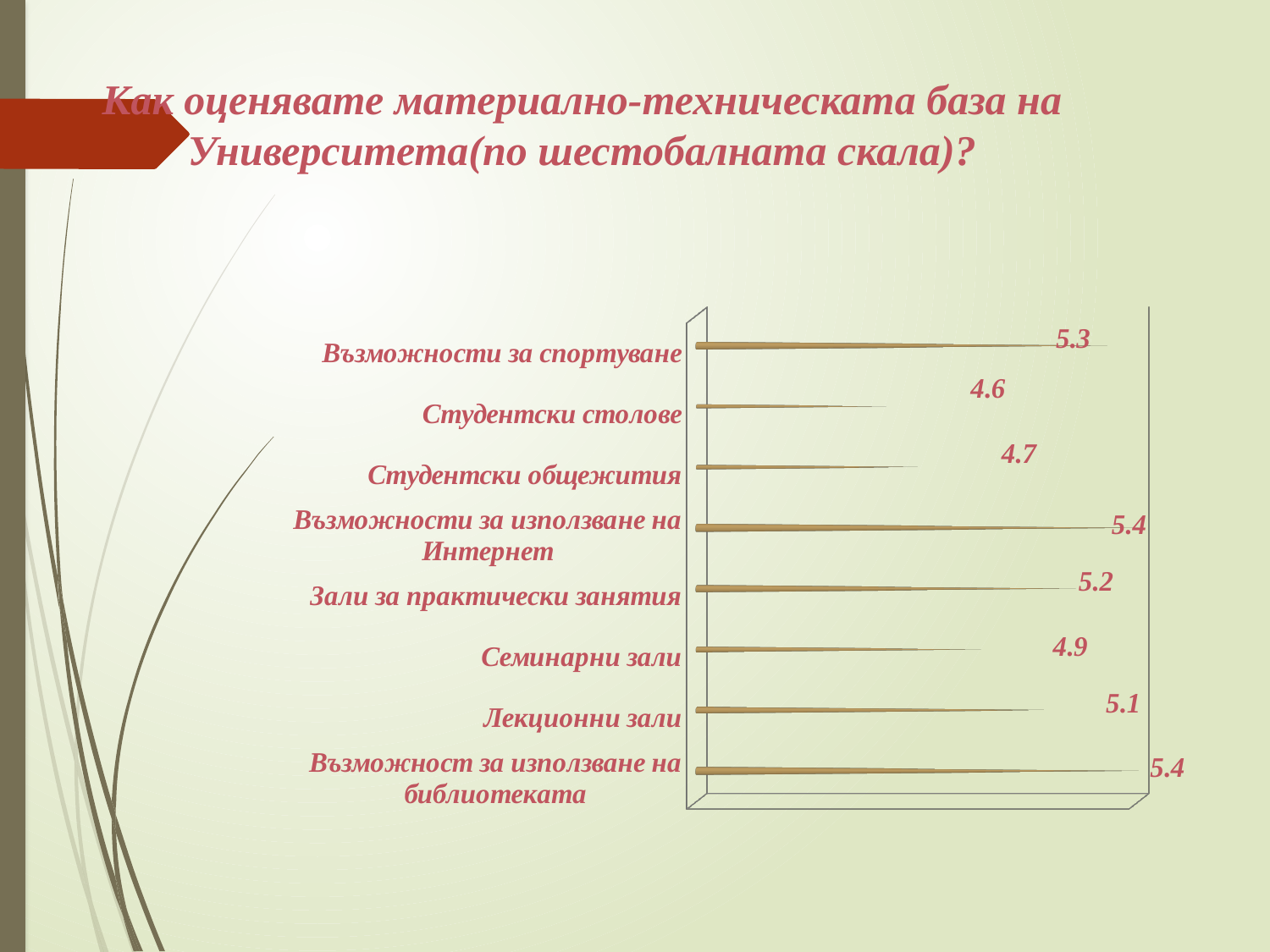
What kind of chart is shown on the slide? Bar chart How many categories are shown in the chart? 8 What is the title of the slide? Как оценявате материално-техническата база на Университета(по шестобалната скала)? Which is larger, the value for Лекционни зали or the value for Възможности за спортуване? Възможности за спортуване What is the value for Студентски столове? 4.6 What is the value for Семинарни зали? 4.9 Which is larger, the value for Зали за практически занятия or the value for Студентски общежития? Зали за практически занятия What is the difference between the values for Възможности за спортуване and Семинарни зали? 0.4 What is the value for Лекционни зали? 5.1 Which category has the lowest value? Студентски столове What is the value for Възможности за използване на Интернет? 5.4 What is the difference between the values for Възможност за използване на библиотеката and Студентски столове? 0.8